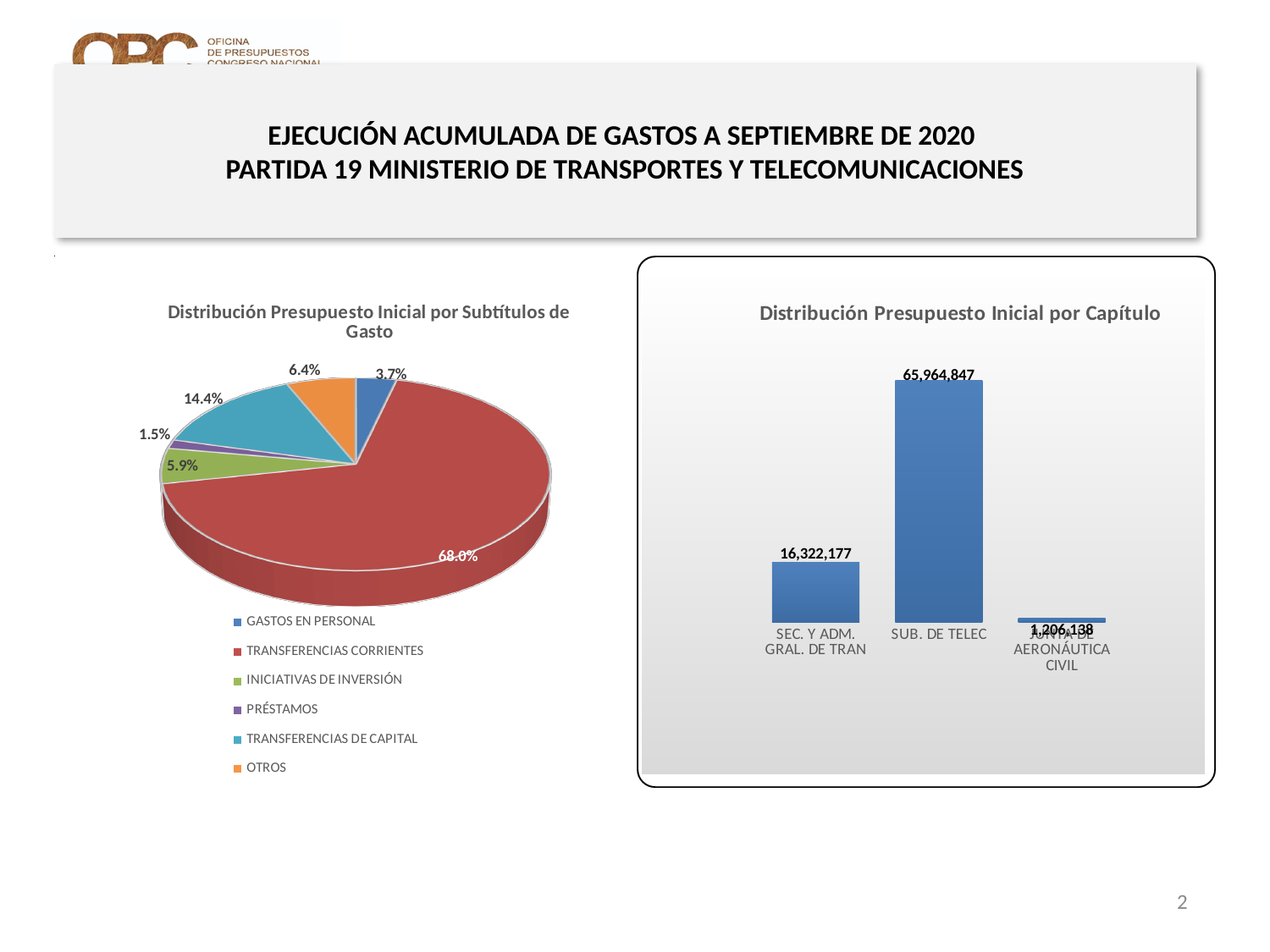
In the pie chart 'Distribución Presupuesto Inicial por Subtítulos de Gasto', what share does TRANSFERENCIAS CORRIENTES have? 68.0% In the 'Distribución Presupuesto Inicial por Capítulo' chart, what is the value for SUB. DE TELEC? 65,964,847 What kind of chart is 'Distribución Presupuesto Inicial por Capítulo'? Bar chart In the 'Distribución Presupuesto Inicial por Capítulo' chart, how many categories are shown? 3 In the 'Distribución Presupuesto Inicial por Capítulo' chart, what is the value for SEC. Y ADM. GRAL. DE TRAN? 16,322,177 How many entries does the legend of the pie chart 'Distribución Presupuesto Inicial por Subtítulos de Gasto' list? 6 In the pie chart 'Distribución Presupuesto Inicial por Subtítulos de Gasto', what share does TRANSFERENCIAS DE CAPITAL have? 14.4% In the 'Distribución Presupuesto Inicial por Capítulo' chart, what is the difference between SUB. DE TELEC and SEC. Y ADM. GRAL. DE TRAN? 49,642,670 In the 'Distribución Presupuesto Inicial por Capítulo' chart, which category has the lowest value? JUNTA DE AERONÁUTICA CIVIL In the pie chart 'Distribución Presupuesto Inicial por Subtítulos de Gasto', which category has the smallest share? PRÉSTAMOS In the 'Distribución Presupuesto Inicial por Capítulo' chart, which category has the highest value? SUB. DE TELEC In the pie chart 'Distribución Presupuesto Inicial por Subtítulos de Gasto', which is larger: OTROS or INICIATIVAS DE INVERSIÓN? OTROS